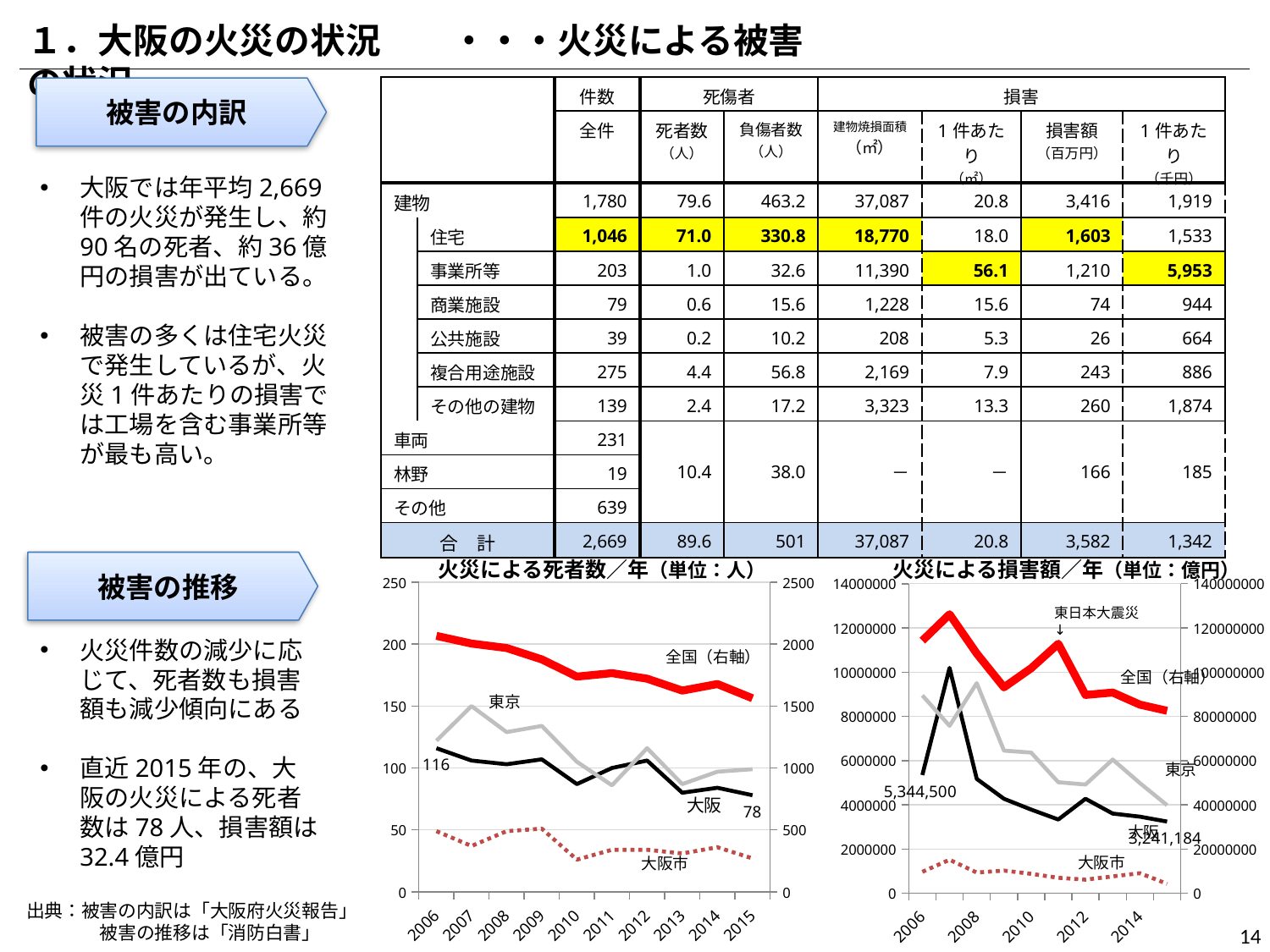
In the left chart (火災による死者数／年), how many years are shown on the x axis? 10 In the left chart (火災による死者数／年), is the value for 大阪市 in 2010 greater or less than 50? less In the left chart (火災による死者数／年), does the 全国（右軸） line rise or fall from 2006 to 2015? fall In the left chart (火災による死者数／年), by how much did the 大阪 value fall from 2006 to 2015? 38 In the left chart (火災による死者数／年), is the value for 東京 in 2007 greater or less than 100? greater In the left chart (火災による死者数／年), what is the value for 大阪 in 2015? 78 In the left chart (火災による死者数／年), which series has the lowest value in 2015? 大阪市 In the left chart (火災による死者数／年), what is the value for 大阪 in 2006? 116 In the right chart (火災による損害額／年), what is the labelled value for 大阪 at the end of the series? 3,241,184 What kind of chart is the left chart titled 火災による死者数／年（単位：人）? line chart In the right chart (火災による損害額／年), which is larger in 2008, the value for 東京 or the value for 大阪? 東京 In the right chart (火災による損害額／年), what is the labelled value for 大阪 in 2006? 5,344,500